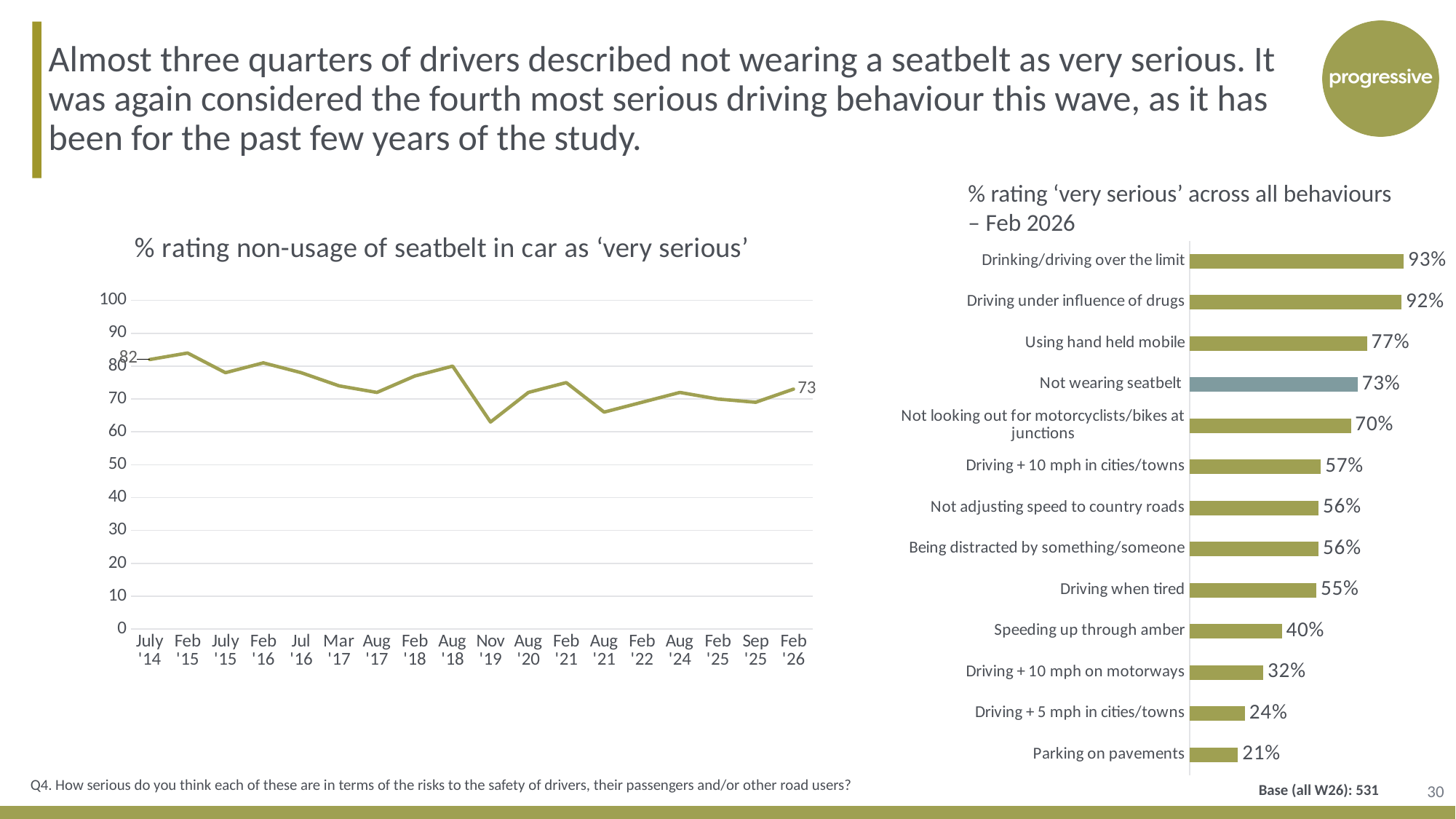
In the chart titled "% rating 'very serious' across all behaviours – Feb 2026", what is the difference between Using hand held mobile and Not wearing seatbelt? 4% In the chart titled "% rating non-usage of seatbelt in car as 'very serious'", is the value for Nov '19 greater or less than 70? less In the chart titled "% rating 'very serious' across all behaviours – Feb 2026", what is the value for Driving when tired? 55% In the chart titled "% rating non-usage of seatbelt in car as 'very serious'", what is the value for July '14? 82 In the chart titled "% rating non-usage of seatbelt in car as 'very serious'", what is the value for Feb '26? 73 In the chart titled "% rating non-usage of seatbelt in car as 'very serious'", how many time points are plotted? 18 In the chart titled "% rating 'very serious' across all behaviours – Feb 2026", which behaviour has the lowest value? Parking on pavements In the chart titled "% rating 'very serious' across all behaviours – Feb 2026", how many behaviours are shown? 13 What kind of chart is the one titled "% rating 'very serious' across all behaviours – Feb 2026"? Bar chart In the chart titled "% rating 'very serious' across all behaviours – Feb 2026", what is the value for Not wearing seatbelt? 73% In the chart titled "% rating 'very serious' across all behaviours – Feb 2026", which is larger: Speeding up through amber or Driving + 10 mph on motorways? Speeding up through amber In the chart titled "% rating 'very serious' across all behaviours – Feb 2026", which behaviour has the highest value? Drinking/driving over the limit